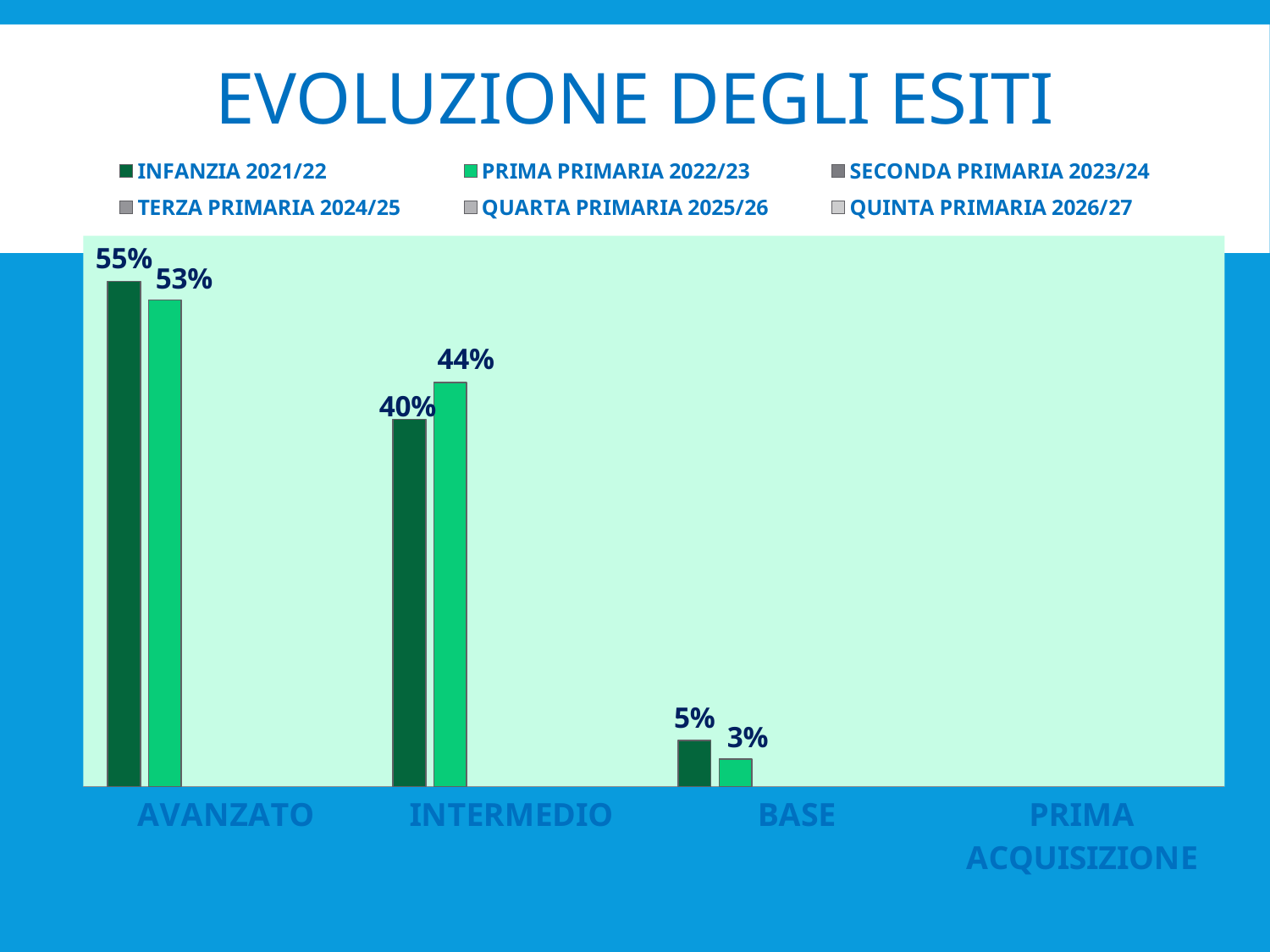
What kind of chart is shown on the slide? Bar chart How many categories are shown on the x axis? 4 What is the value for PRIMA PRIMARIA 2022/23 in the BASE category? 3% What is the value for INFANZIA 2021/22 in the AVANZATO category? 55% In the AVANZATO category, which series has the larger value: INFANZIA 2021/22 or PRIMA PRIMARIA 2022/23? INFANZIA 2021/22 What is the value for INFANZIA 2021/22 in the INTERMEDIO category? 40% What is the title of the chart? EVOLUZIONE DEGLI ESITI What is the difference between the INFANZIA 2021/22 and PRIMA PRIMARIA 2022/23 values in the INTERMEDIO category? 4% What is the value for PRIMA PRIMARIA 2022/23 in the INTERMEDIO category? 44% How many series does the legend list? 6 Which category has the lowest value for PRIMA PRIMARIA 2022/23 among those with plotted bars? BASE Which category has the highest value for INFANZIA 2021/22? AVANZATO